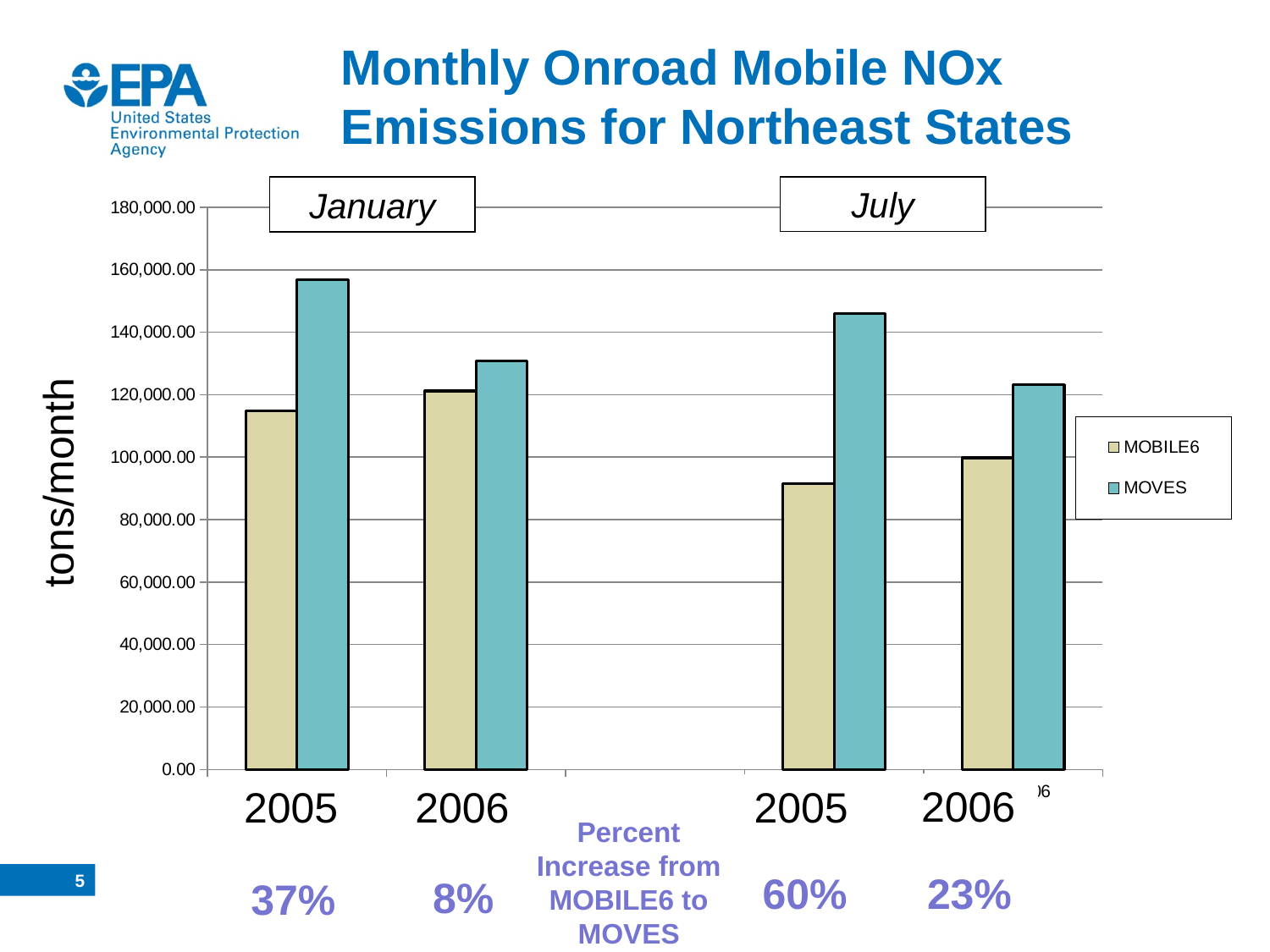
Does the MOVES value for January rise or fall from 2005 to 2006? fall Which month and year has the highest MOVES bar? January 2005 Is the MOVES value for January 2005 greater or less than 140,000.00? greater For July 2005, which is larger, the MOBILE6 value or the MOVES value? MOVES Which series has the tallest bar on the chart? MOVES What is the unit shown on the vertical axis? tons/month Is the MOBILE6 value for July 2005 greater or less than 100,000.00? less Is the MOVES value for January 2006 greater or less than 140,000.00? less How many series does the legend list? 2 What percent increase from MOBILE6 to MOVES is shown for July 2005? 60% What kind of chart is shown on the slide? bar chart Which month and year has the lowest MOBILE6 bar? July 2005